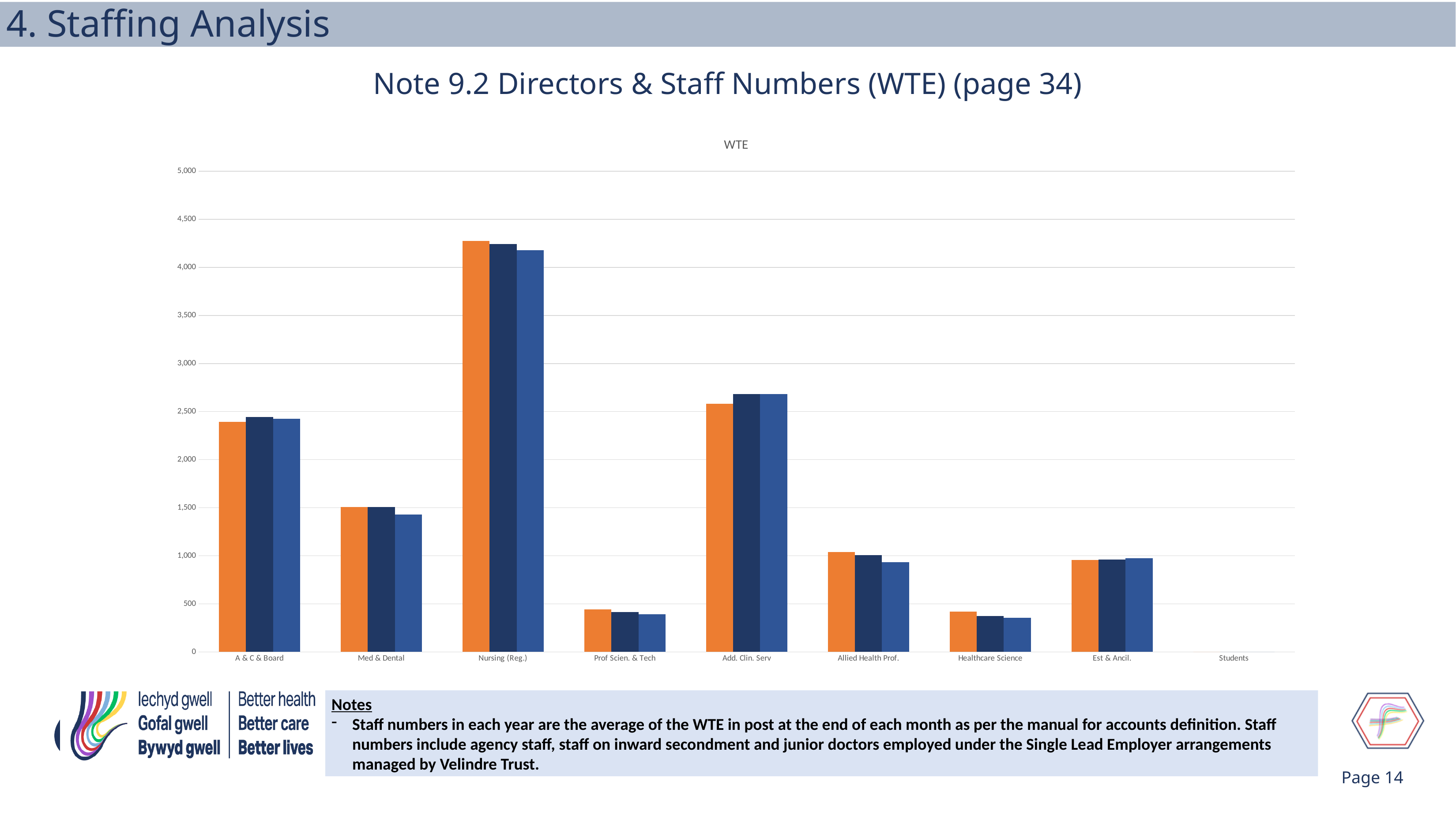
Is the orange bar for Add. Clin. Serv greater or less than 2,500? greater Which category has higher bars, Allied Health Prof. or Healthcare Science? Allied Health Prof. Is the orange bar for A & C & Board greater or less than 2,000? greater Which category has higher bars, Nursing (Reg.) or Add. Clin. Serv? Nursing (Reg.) What kind of chart is shown on the slide? Bar chart Is the orange bar for Nursing (Reg.) greater or less than 4,000? greater How many bars are plotted for the A & C & Board category? 3 Which category has the highest bars in the chart? Nursing (Reg.) Which category on the x axis shows no visible bars? Students What is the title of the chart? WTE How many categories are shown on the x axis of the chart? 9